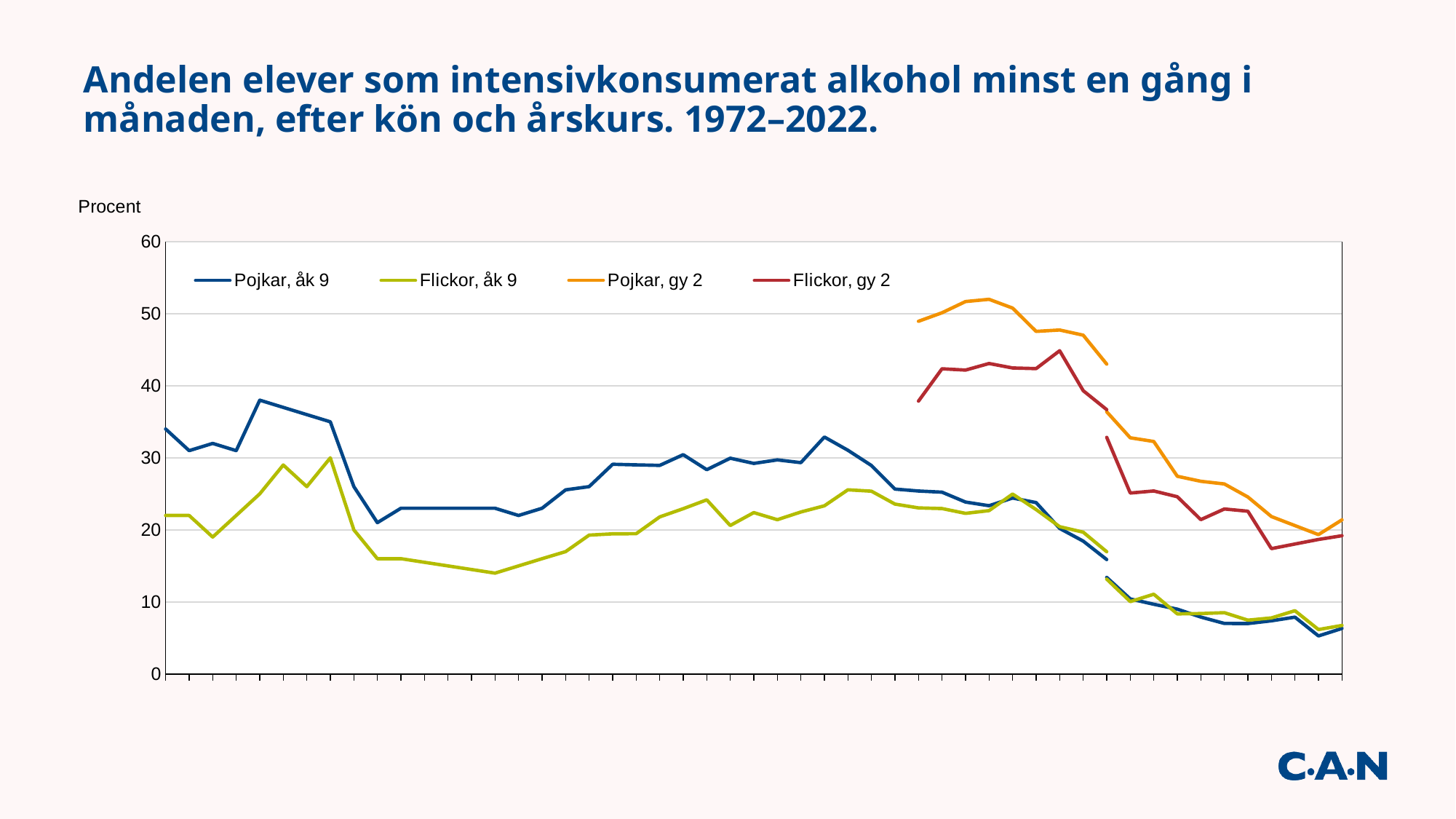
Is the last (rightmost) value of the Pojkar, åk 9 series greater or less than 10? less Which series reaches the highest value anywhere on the chart? Pojkar, gy 2 What kind of chart is shown on the slide? Line chart At the right end of the chart, which series is higher: Pojkar, gy 2 or Flickor, åk 9? Pojkar, gy 2 How many series does the legend list? 4 Over the most recent part of the chart, do the values of the Pojkar, gy 2 series rise or fall? fall What unit is shown on the vertical axis label? Procent At the left end of the chart, which series is higher: Pojkar, åk 9 or Flickor, åk 9? Pojkar, åk 9 Is the peak value of the Pojkar, gy 2 series greater or less than 50? greater Is the first (leftmost) value of the Flickor, gy 2 series greater or less than 30? greater What is the title of the chart? Andelen elever som intensivkonsumerat alkohol minst en gång i månaden, efter kön och årskurs. 1972–2022.